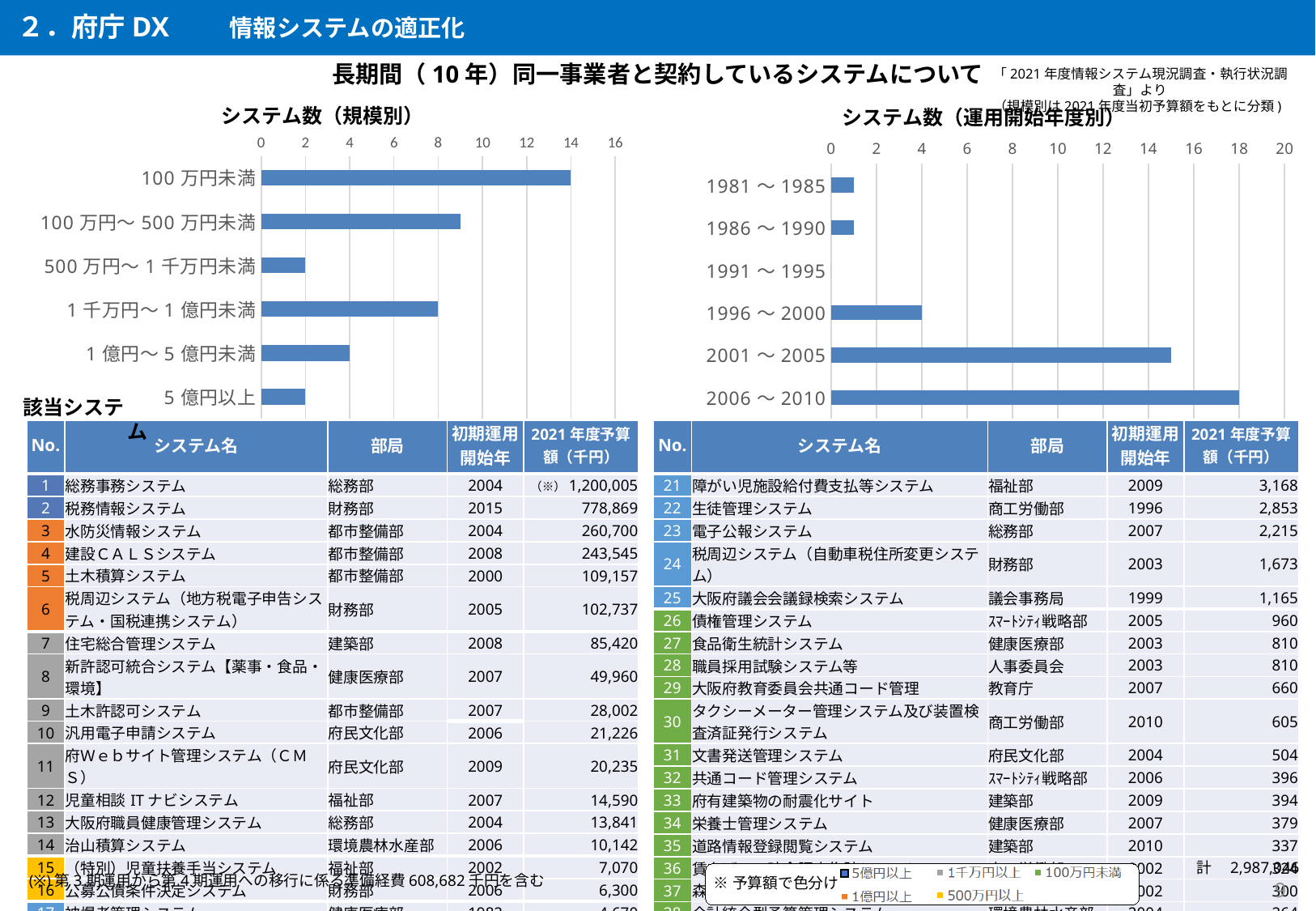
In the システム数（規模別） chart, which is larger: 1億円～5億円未満 or 5億円以上? 1億円～5億円未満 In the システム数（規模別） chart, how many categories are shown? 6 In the システム数（運用開始年度別） chart, what is the difference between the values for 2006～2010 and 1996～2000? 14 In the システム数（運用開始年度別） chart, which period has the highest number of systems? 2006～2010 In the システム数（運用開始年度別） chart, what is the value for 2006～2010? 18 In the システム数（規模別） chart, is the value for 100万円～500万円未満 greater or less than 10? less In the システム数（運用開始年度別） chart, is the value for 2001～2005 greater or less than 14? greater In the システム数（規模別） chart, which category has the highest number of systems? 100万円未満 In the システム数（運用開始年度別） chart, what is the value for 1996～2000? 4 What kind of chart is the システム数（規模別） chart on the left? bar chart In the システム数（運用開始年度別） chart, which period has the lowest number of systems? 1991～1995 In the システム数（規模別） chart, what is the value for 1千万円～1億円未満? 8